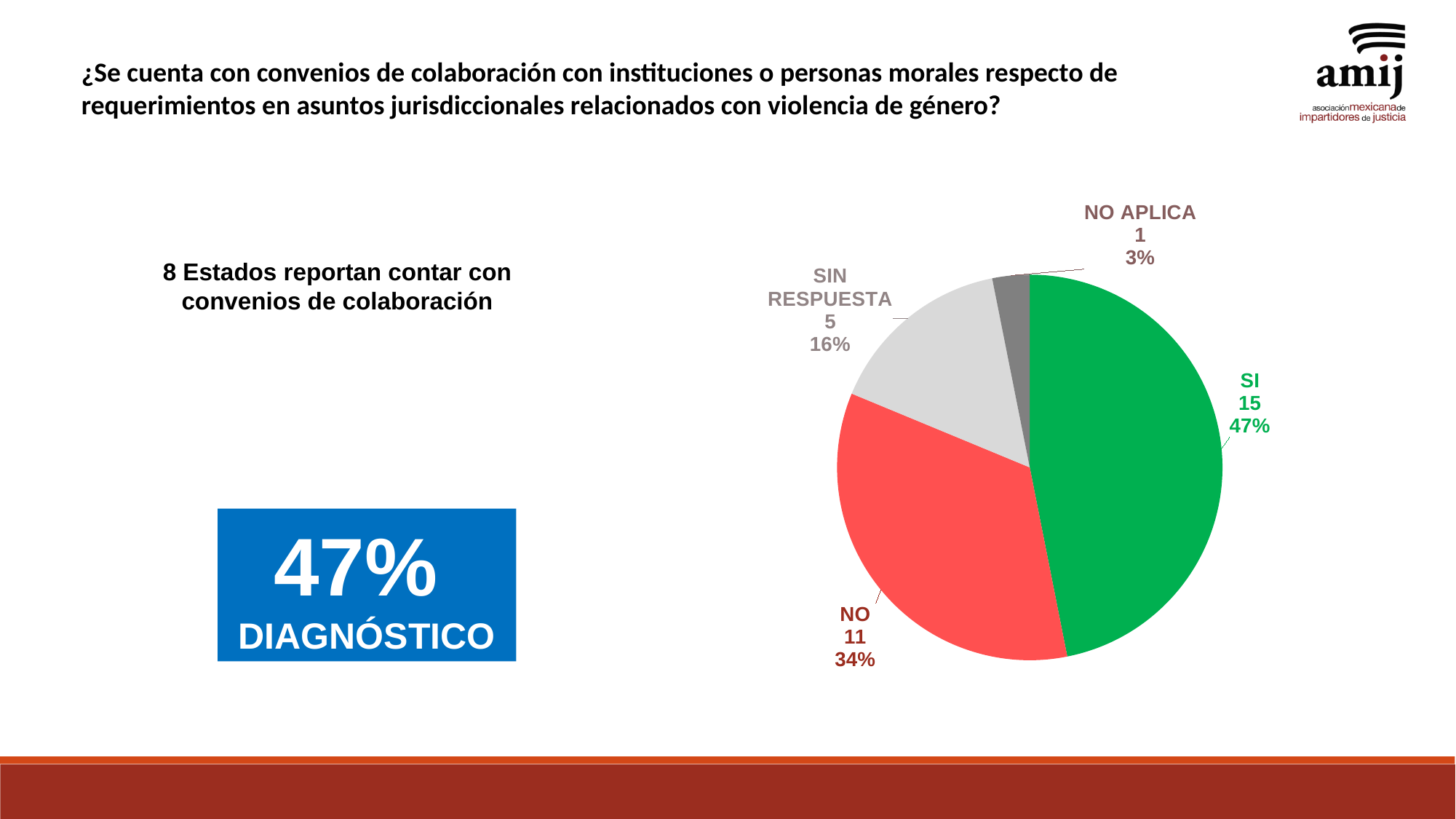
What is the count for the SI slice? 15 Which category has the largest slice? SI What kind of chart is shown on the slide? pie chart What colour is the SI slice? green What is the count for SIN RESPUESTA? 5 Which category has the smallest slice? NO APLICA Which is larger, the count for NO or the count for SIN RESPUESTA? NO What is the difference between the counts for SI and NO? 4 What percentage does the NO APLICA slice represent? 3% What percentage does the NO slice represent? 34% How many slices does the pie chart have? 4 What is the total count across all slices of the pie chart? 32